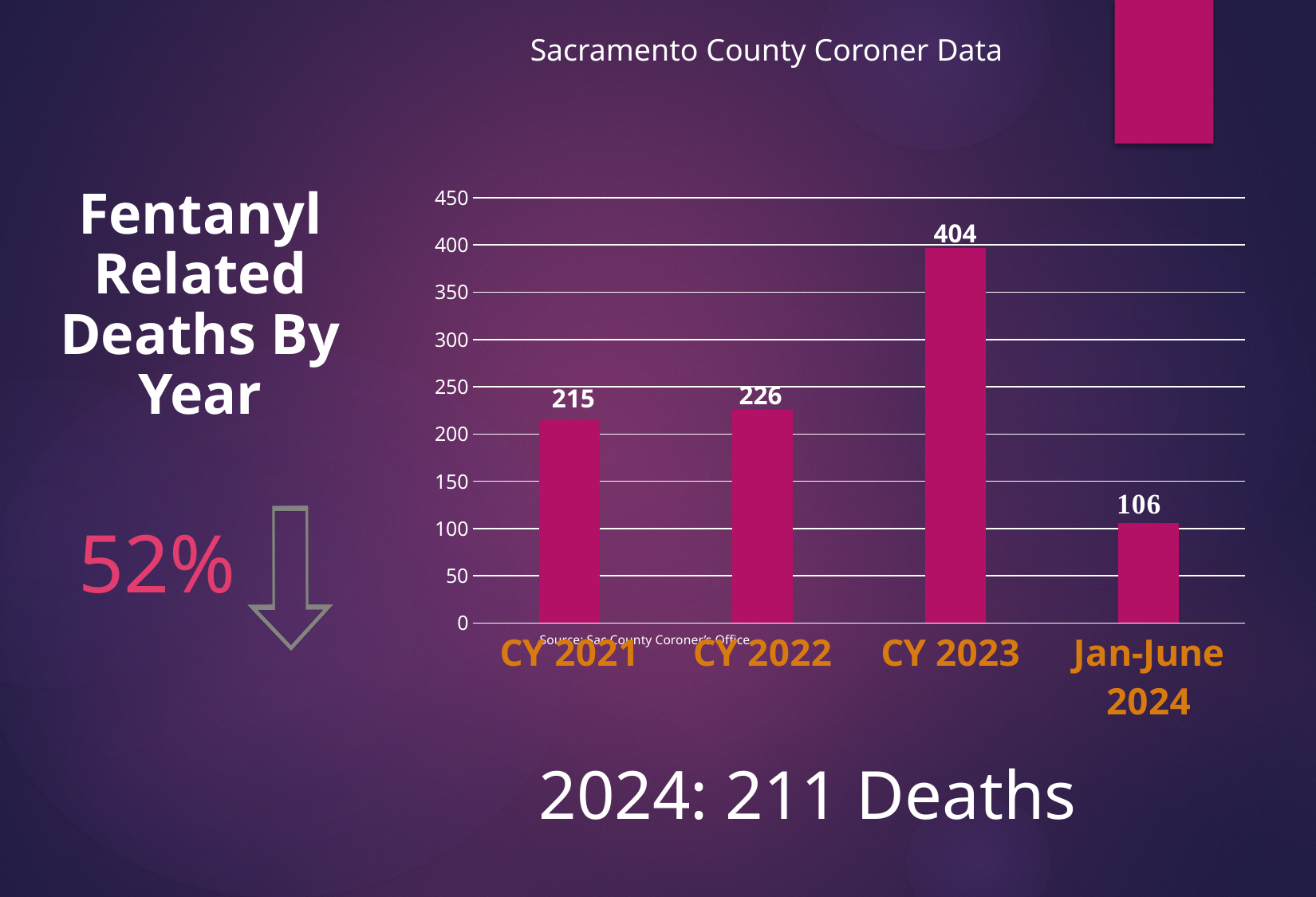
Which category has the highest value? CY 2023 Is the value for CY 2023 greater or less than 350? greater What is the value for CY 2023? 404 Which category has the lowest value? Jan-June 2024 What is the difference between the values for CY 2023 and CY 2022? 178 What is the difference between the values for CY 2022 and CY 2021? 11 How many categories are shown on the x axis? 4 What is the value for CY 2022? 226 What kind of chart is shown on the slide? bar chart What is the value for CY 2021? 215 Which is larger, the value for CY 2023 or the value for CY 2021? CY 2023 What is the value for Jan-June 2024? 106